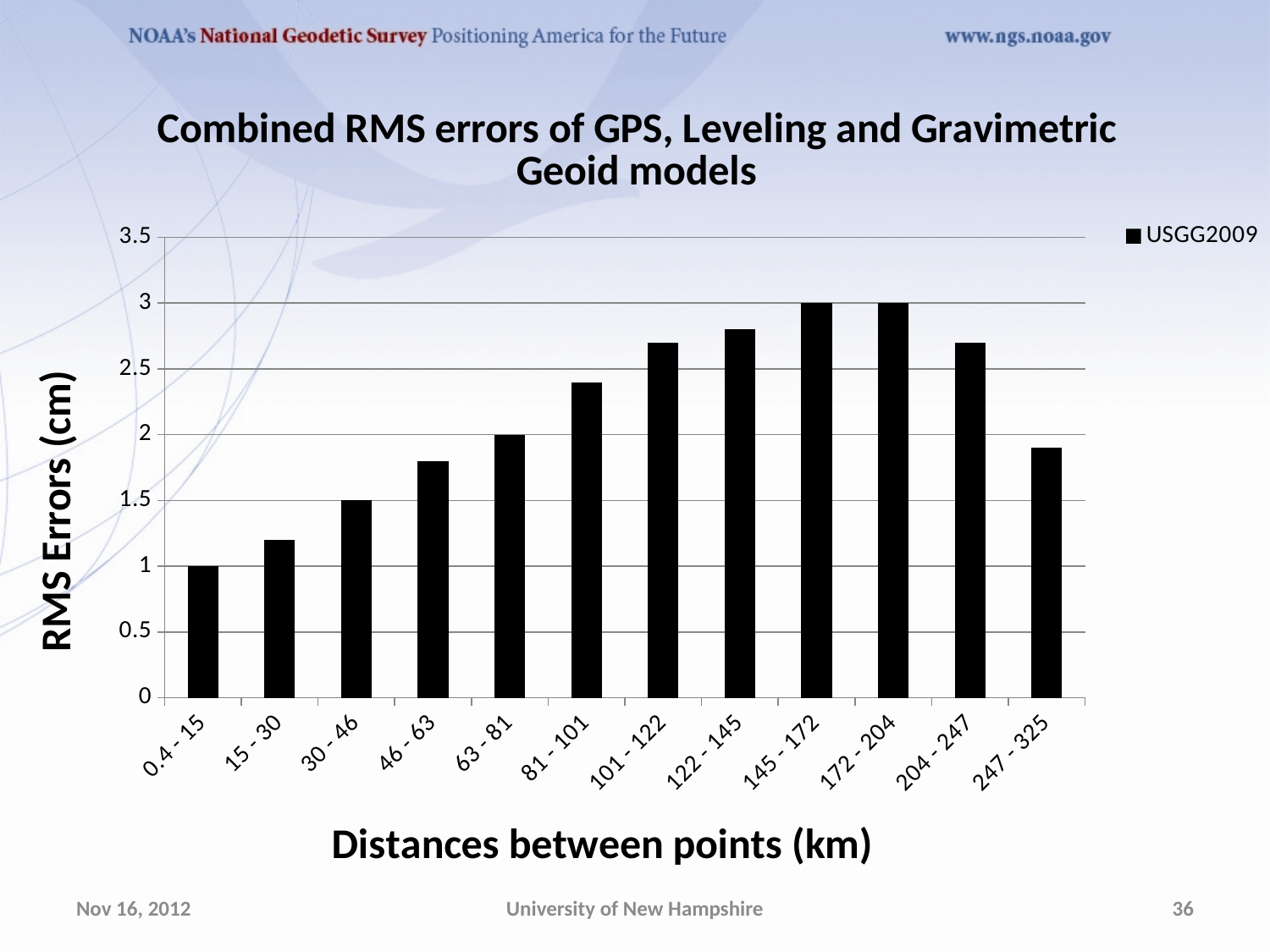
What is the RMS error for the 30 - 46 km distance category? 1.5 What is the difference between the RMS error for 63 - 81 km and for 0.4 - 15 km? 1 Which has a larger RMS error, the 81 - 101 km category or the 15 - 30 km category? 81 - 101 How many distance categories are shown on the x axis? 12 What is the RMS error for the 0.4 - 15 km distance category? 1 What is the RMS error for the 145 - 172 km distance category? 3 Is the RMS error for the 247 - 325 km category greater or less than 2? less What is the RMS error for the 63 - 81 km distance category? 2 What type of chart is shown on the slide? bar chart Is the RMS error for the 122 - 145 km category greater or less than 2.5? greater Which distance category has the lowest RMS error? 0.4 - 15 How many series does the legend list? 1